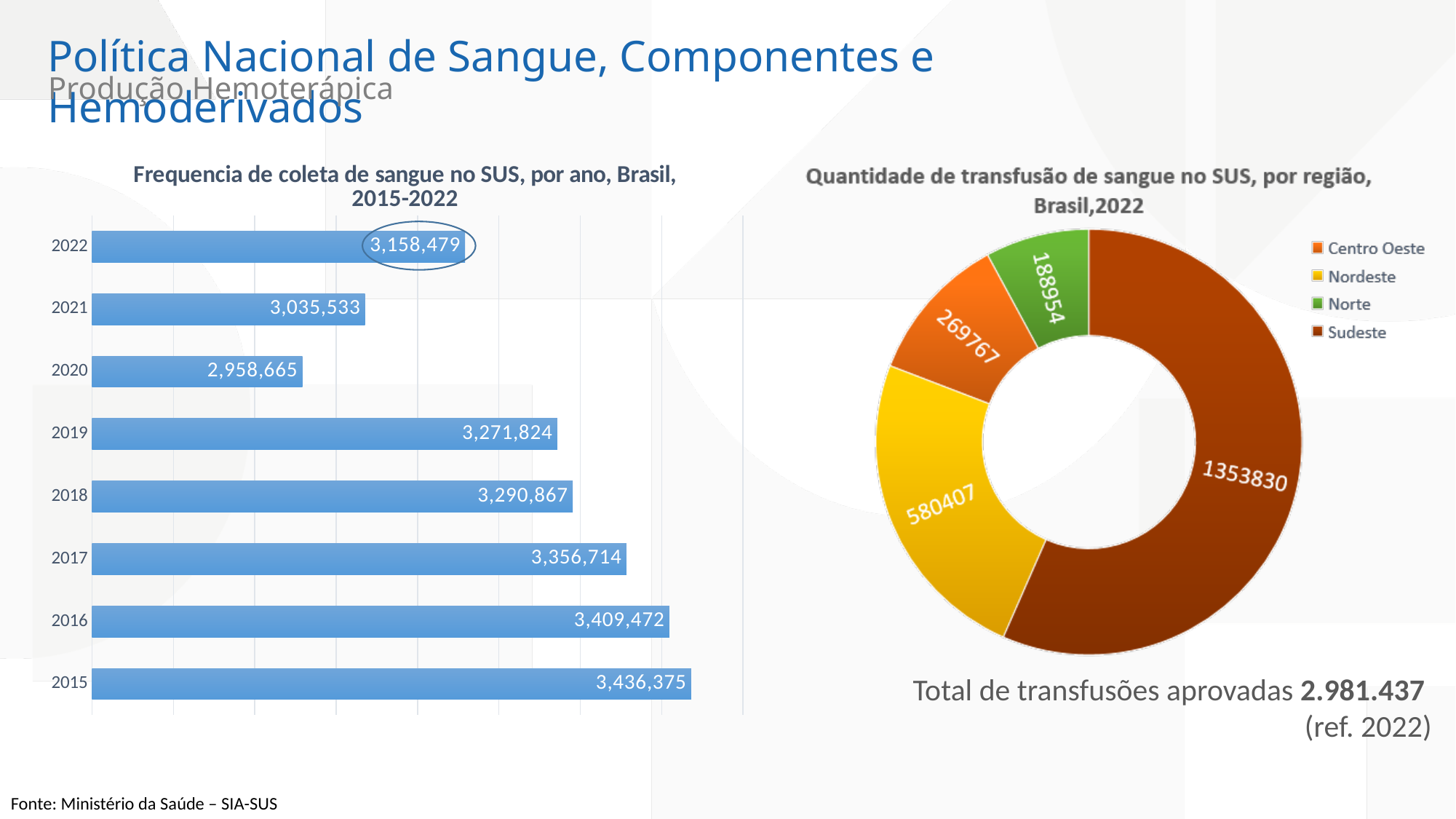
In the bar chart on the left, which year has the highest value? 2015 In the bar chart on the left, do the values rise or fall from 2015 to 2020? fall In the bar chart on the left, what is the value for 2018? 3,290,867 In the bar chart on the left, what is the difference between the values for 2022 and 2021? 122,946 In the bar chart on the left, which year has the lowest value? 2020 In the doughnut chart 'Quantidade de transfusão de sangue no SUS, por região, Brasil, 2022', what is the value for Nordeste? 580407 In the bar chart on the left, which is larger, the value for 2019 or the value for 2017? 2017 How many years are shown in the bar chart on the left? 8 In the bar chart 'Frequencia de coleta de sangue no SUS, por ano, Brasil, 2015-2022', what is the value for 2022? 3,158,479 In the doughnut chart on the right, which region has the largest value? Sudeste How many regions does the legend of the doughnut chart on the right list? 4 In the doughnut chart on the right, what is the difference between the values for Sudeste and Nordeste? 773423